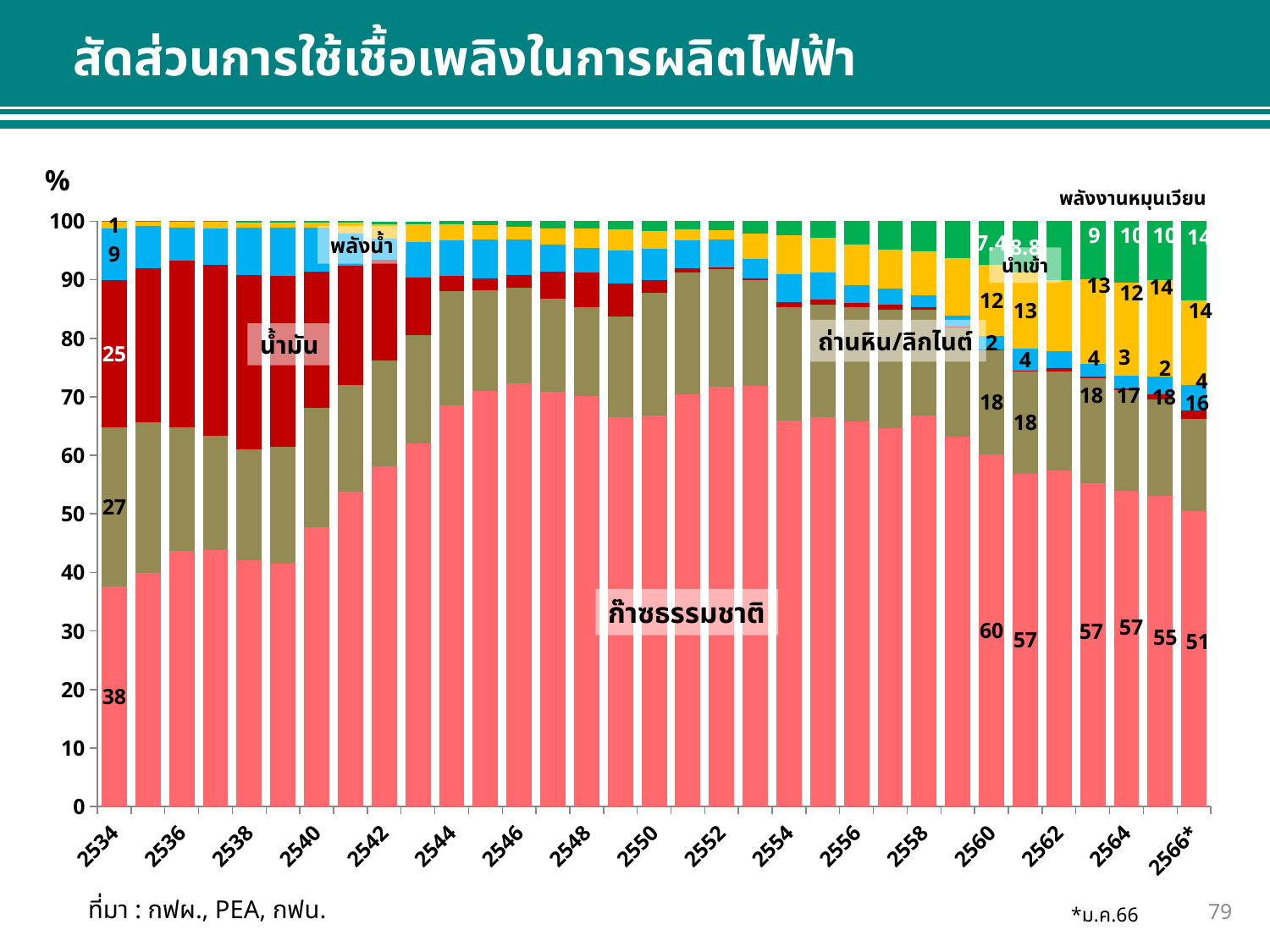
Does the share of ก๊าซธรรมชาติ (natural gas) rise or fall from 2560 to 2566*? fall What is the share of พลังงานหมุนเวียน (renewable energy) in 2560? 7.4 By how much did the share of ก๊าซธรรมชาติ (natural gas) fall from 2534 to 2566*? 13 Is the share of ก๊าซธรรมชาติ (natural gas) in 2540 greater or less than 50? less What is the share of ก๊าซธรรมชาติ (natural gas) in 2560? 60 What is the share of น้ำมัน (oil) in 2534? 25 What kind of chart is shown on the slide? stacked bar chart What is the share of ก๊าซธรรมชาติ (natural gas) in 2566*? 51 Which year has the larger share of ก๊าซธรรมชาติ (natural gas), 2560 or 2566*? 2560 What is the share of พลังงานหมุนเวียน (renewable energy) in 2566*? 14 What is the share of ถ่านหิน/ลิกไนต์ (coal/lignite) in 2534? 27 What is the share of ก๊าซธรรมชาติ (natural gas) in 2534? 38